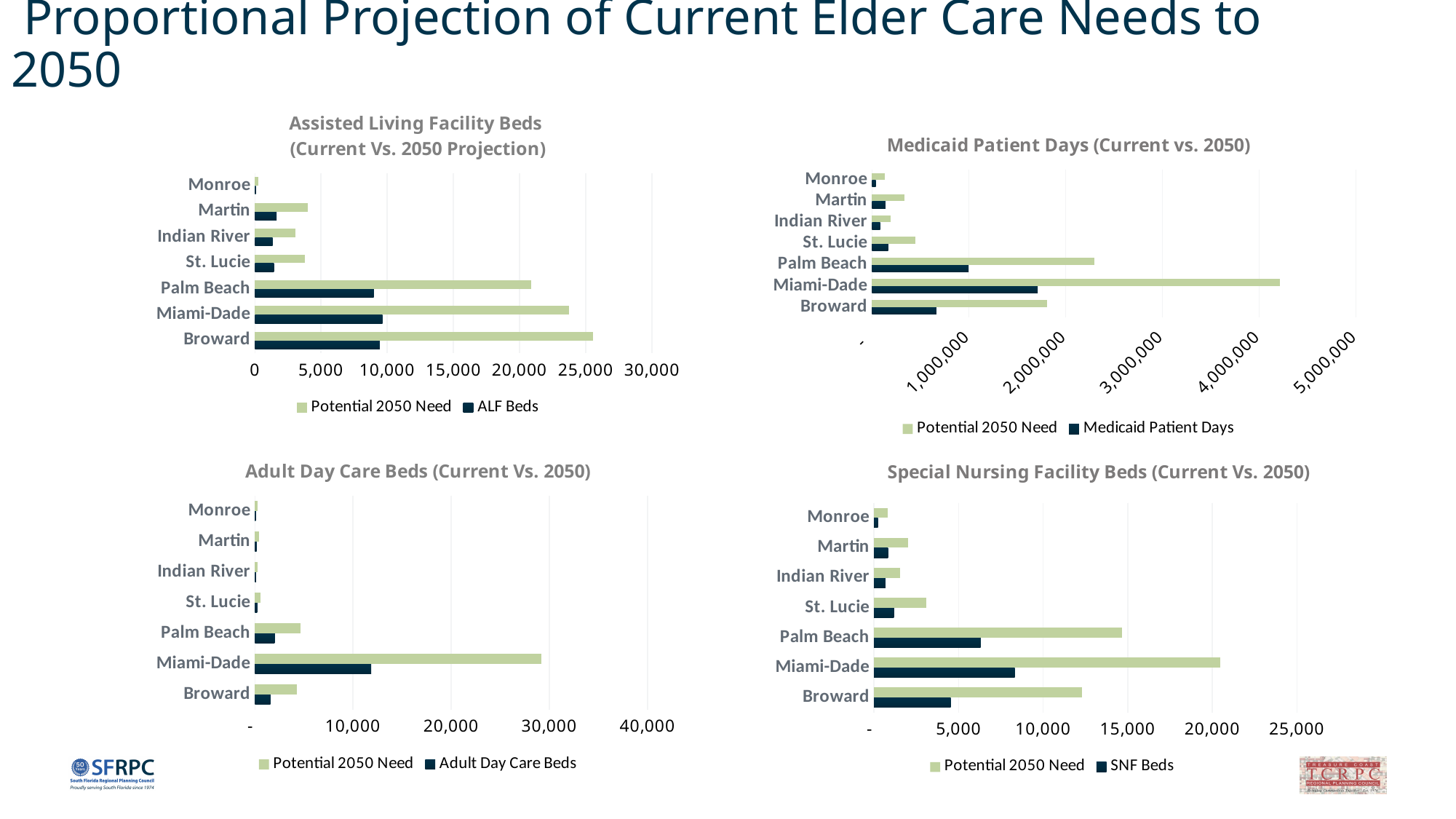
In the 'Special Nursing Facility Beds (Current Vs. 2050)' chart, which county has the larger Potential 2050 Need, Palm Beach or Broward? Palm Beach How many series does the legend of the 'Medicaid Patient Days (Current vs. 2050)' chart list? 2 In the 'Assisted Living Facility Beds' chart, how many counties are listed on the vertical axis? 7 In the 'Adult Day Care Beds (Current Vs. 2050)' chart, which county has the highest Potential 2050 Need? Miami-Dade In the 'Assisted Living Facility Beds' chart, is the Potential 2050 Need for Palm Beach greater or less than 20,000? greater In the 'Assisted Living Facility Beds' chart, which county has the lowest Potential 2050 Need? Monroe What type of chart is the 'Assisted Living Facility Beds (Current Vs. 2050 Projection)' chart? Bar chart In the 'Medicaid Patient Days (Current vs. 2050)' chart, which county has the highest Potential 2050 Need? Miami-Dade What are the two legend entries of the 'Special Nursing Facility Beds (Current Vs. 2050)' chart? Potential 2050 Need and SNF Beds In the 'Assisted Living Facility Beds' chart, which county has the highest Potential 2050 Need? Broward How many charts are shown on the slide? 4 In the 'Medicaid Patient Days (Current vs. 2050)' chart, is the Potential 2050 Need for Miami-Dade greater or less than 4,000,000? greater